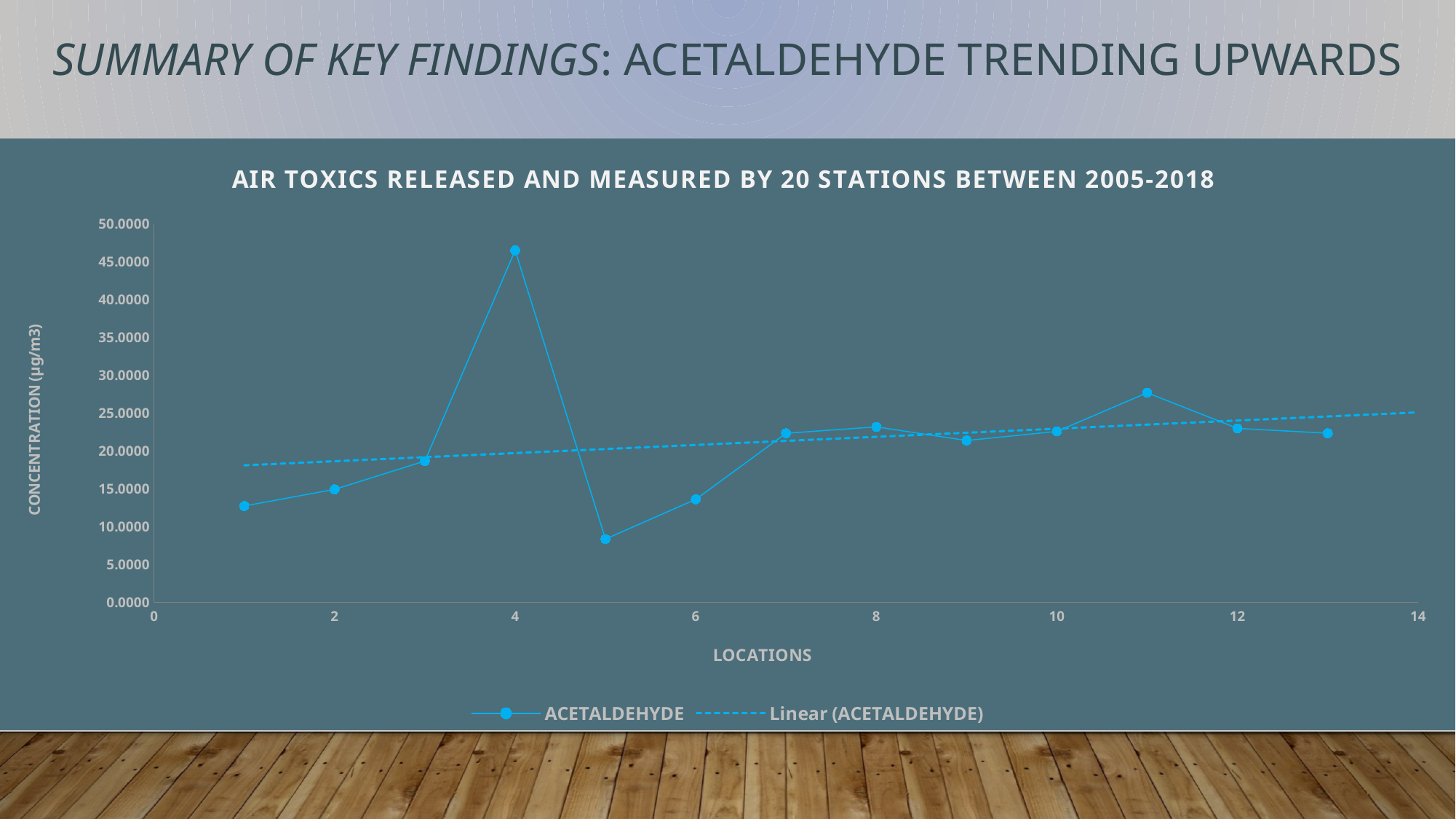
Does the dashed linear trendline rise or fall from left to right? rise What is the title of the chart? AIR TOXICS RELEASED AND MEASURED BY 20 STATIONS BETWEEN 2005-2018 How many series does the legend list? 2 Is the ACETALDEHYDE value at location 11 greater or less than 25.0000? greater What kind of chart is shown on the slide? line chart Is the ACETALDEHYDE value at location 4 greater or less than 40.0000? greater At which location is the ACETALDEHYDE concentration highest? 4 How many data points are plotted for ACETALDEHYDE? 13 Which has the larger ACETALDEHYDE value, location 1 or location 3? location 3 Is the ACETALDEHYDE value at location 5 greater or less than 10.0000? less At which location is the ACETALDEHYDE concentration lowest? 5 Which has the larger ACETALDEHYDE value, location 5 or location 6? location 6